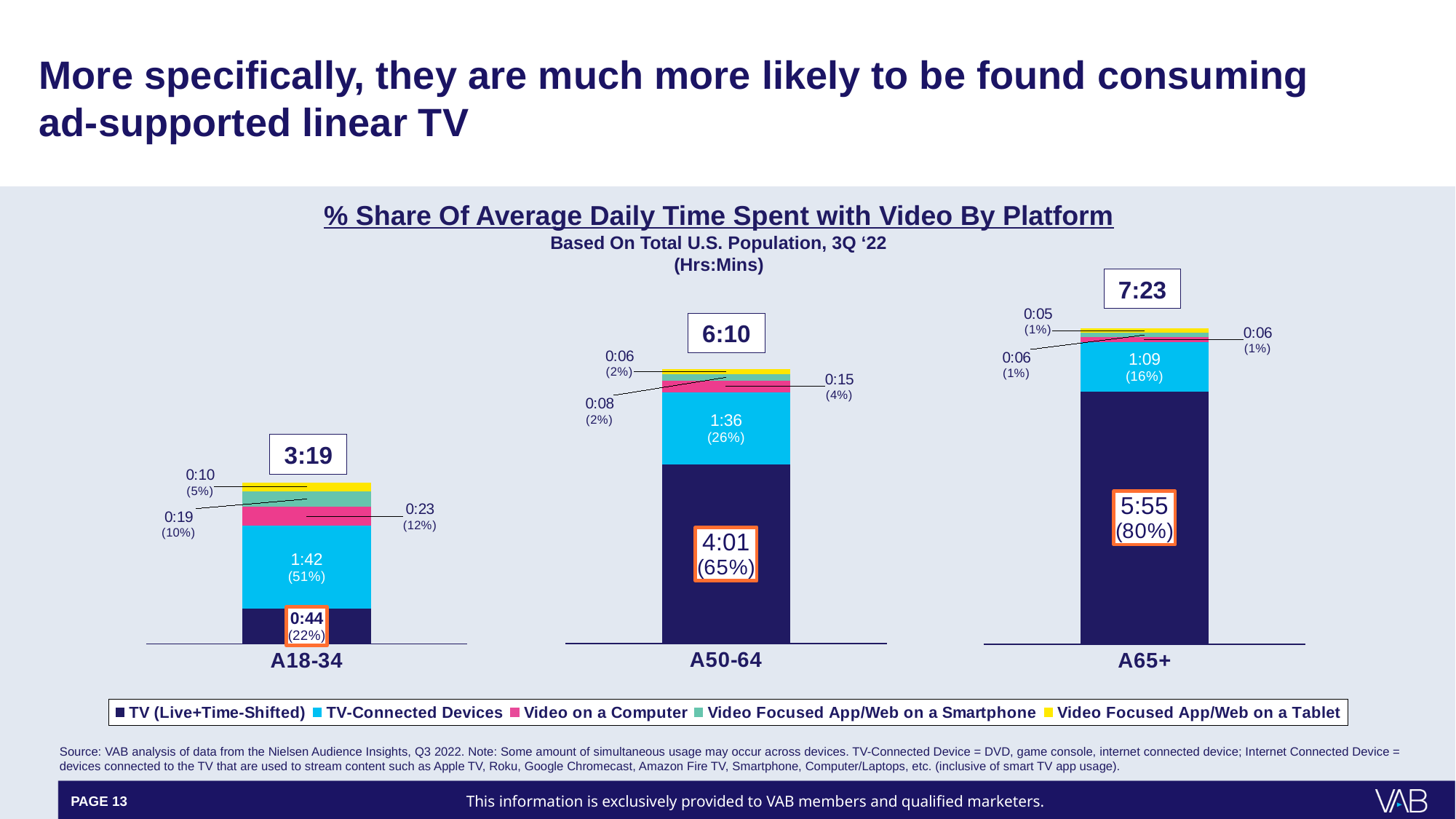
What kind of chart is shown on the slide? Stacked bar chart What is the value for TV-Connected Devices in the A18-34 group? 1:42 What is the value for TV (Live+Time-Shifted) in the A50-64 group? 4:01 What share of daily video time does TV (Live+Time-Shifted) account for in the A65+ group? 80% What is the total average daily time spent with video for the A18-34 group? 3:19 Which age group has the lowest total average daily time spent with video? A18-34 How many age groups are shown on the chart? 3 What share of daily video time do TV-Connected Devices account for in the A50-64 group? 26% Which is larger in the A18-34 group: the time for TV (Live+Time-Shifted) or the time for TV-Connected Devices? TV-Connected Devices How many series does the legend list? 5 What is the total average daily time spent with video for the A65+ group? 7:23 Which age group has the highest total average daily time spent with video? A65+